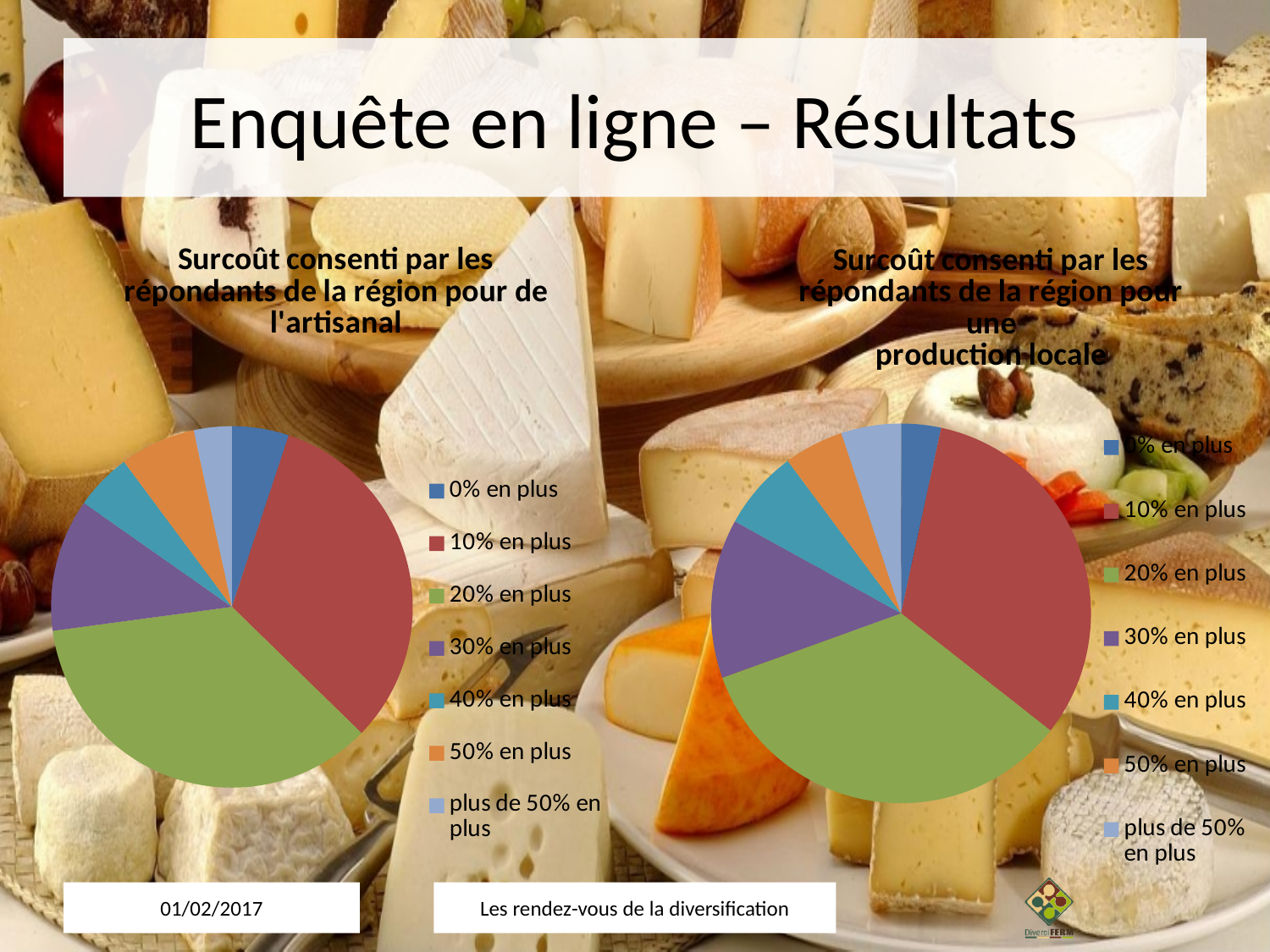
In the left pie chart (pour de l'artisanal), which category has the largest slice? 20% en plus How many entries does the legend of the right pie chart (pour une production locale) list? 7 In the right pie chart (pour une production locale), which slice is larger: 30% en plus or 50% en plus? 30% en plus What kind of chart is used on the right of the slide? pie chart What is the title of the pie chart on the right of the slide? Surcoût consenti par les répondants de la région pour une production locale What kind of chart is used on the left of the slide? pie chart In the left pie chart (pour de l'artisanal), which slice is larger: 20% en plus or 30% en plus? 20% en plus In the left pie chart, which colour represents the category 20% en plus? green In the left pie chart (pour de l'artisanal), which slice is larger: 10% en plus or 0% en plus? 10% en plus How many slices does the left pie chart (pour de l'artisanal) have? 7